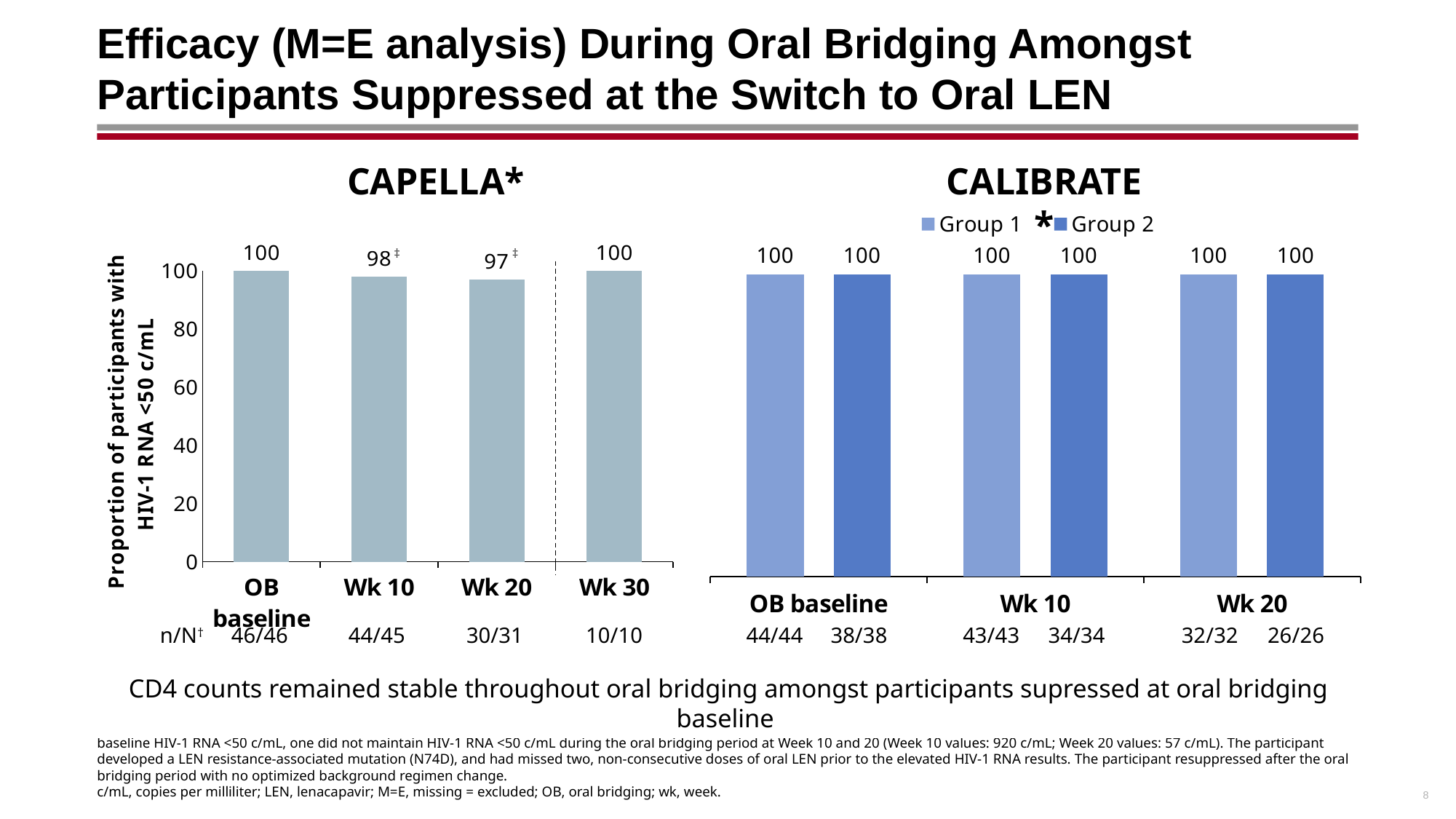
How many series does the legend of the CALIBRATE chart list? 2 What kind of chart is the CALIBRATE chart? Bar chart In the CAPELLA chart, which is larger, the value for Wk 10 or the value for Wk 20? Wk 10 In the CALIBRATE chart, what is the value for Group 2 at Wk 20? 100 What are the two series named in the legend of the CALIBRATE chart? Group 1 and Group 2 In the CAPELLA chart, is the value for Wk 10 greater or less than 80? greater In the CAPELLA chart, what is the value for Wk 10? 98 In the CAPELLA chart, what is the difference between the OB baseline value and the Wk 20 value? 3 In the CAPELLA chart, which category has the lowest value? Wk 20 How many categories are shown on the x axis of the CALIBRATE chart? 3 How many categories are shown on the x axis of the CAPELLA chart? 4 In the CAPELLA chart, what is the value for Wk 20? 97